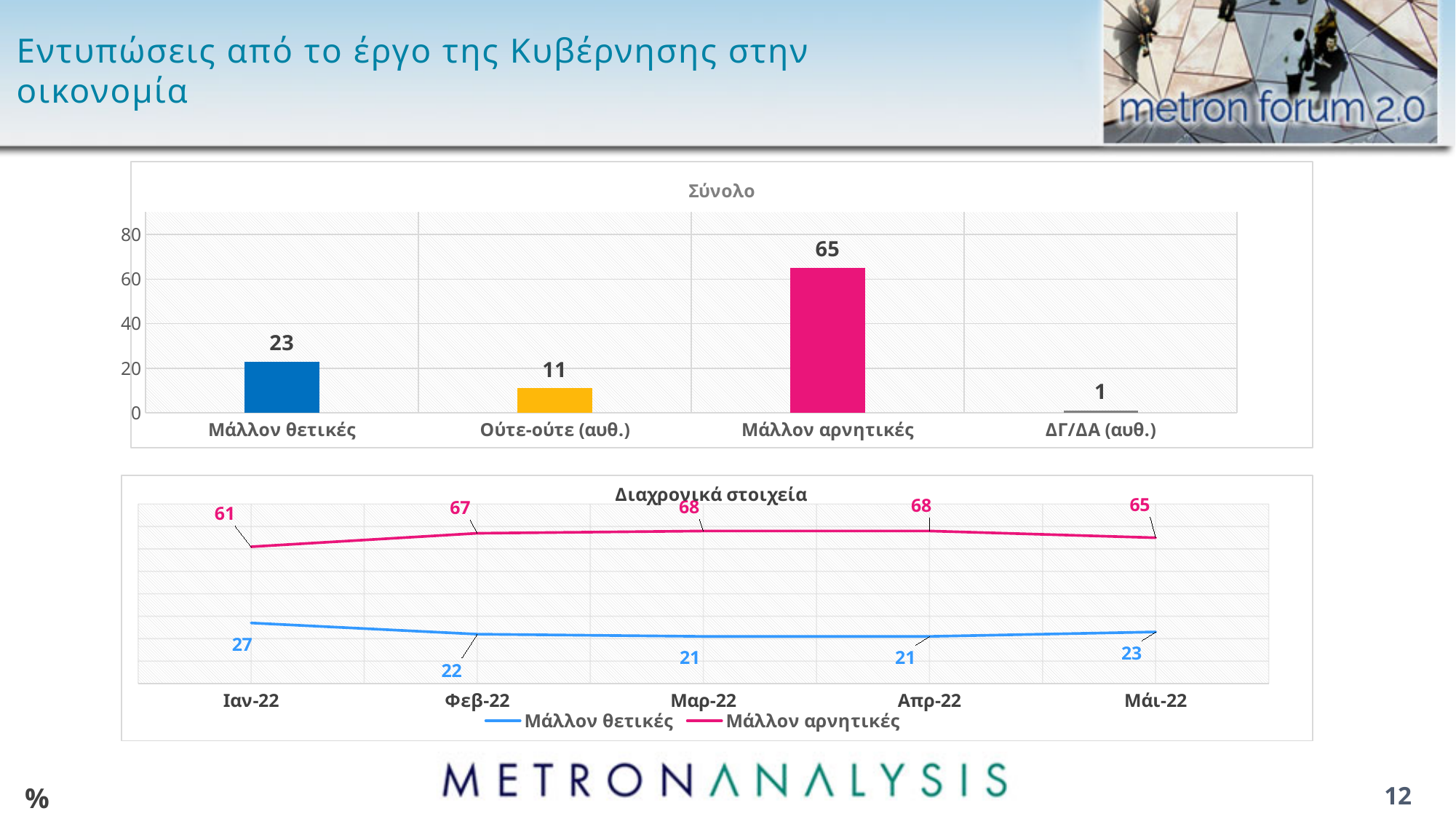
In the 'Διαχρονικά στοιχεία' chart, what is the value for 'Μάλλον θετικές' in Ιαν-22? 27 In the 'Διαχρονικά στοιχεία' chart, what is the difference between 'Μάλλον αρνητικές' and 'Μάλλον θετικές' in Μάι-22? 42 In the 'Διαχρονικά στοιχεία' chart, how many series does the legend list? 2 In the 'Διαχρονικά στοιχεία' chart, what is the value for 'Μάλλον αρνητικές' in Μαρ-22? 68 In the 'Σύνολο' chart, what is the value for 'Ούτε-ούτε (αυθ.)'? 11 In the 'Σύνολο' chart, how many categories are shown? 4 In the 'Διαχρονικά στοιχεία' chart, which is larger in Φεβ-22: 'Μάλλον θετικές' or 'Μάλλον αρνητικές'? Μάλλον αρνητικές In the 'Σύνολο' chart, what is the difference between 'Μάλλον αρνητικές' and 'Μάλλον θετικές'? 42 In the 'Σύνολο' chart, which category has the lowest value? ΔΓ/ΔΑ (αυθ.) What kind of chart is the 'Σύνολο' chart? Bar chart In the 'Σύνολο' chart, which category has the highest value? Μάλλον αρνητικές In the 'Σύνολο' chart, what is the value for 'Μάλλον αρνητικές'? 65